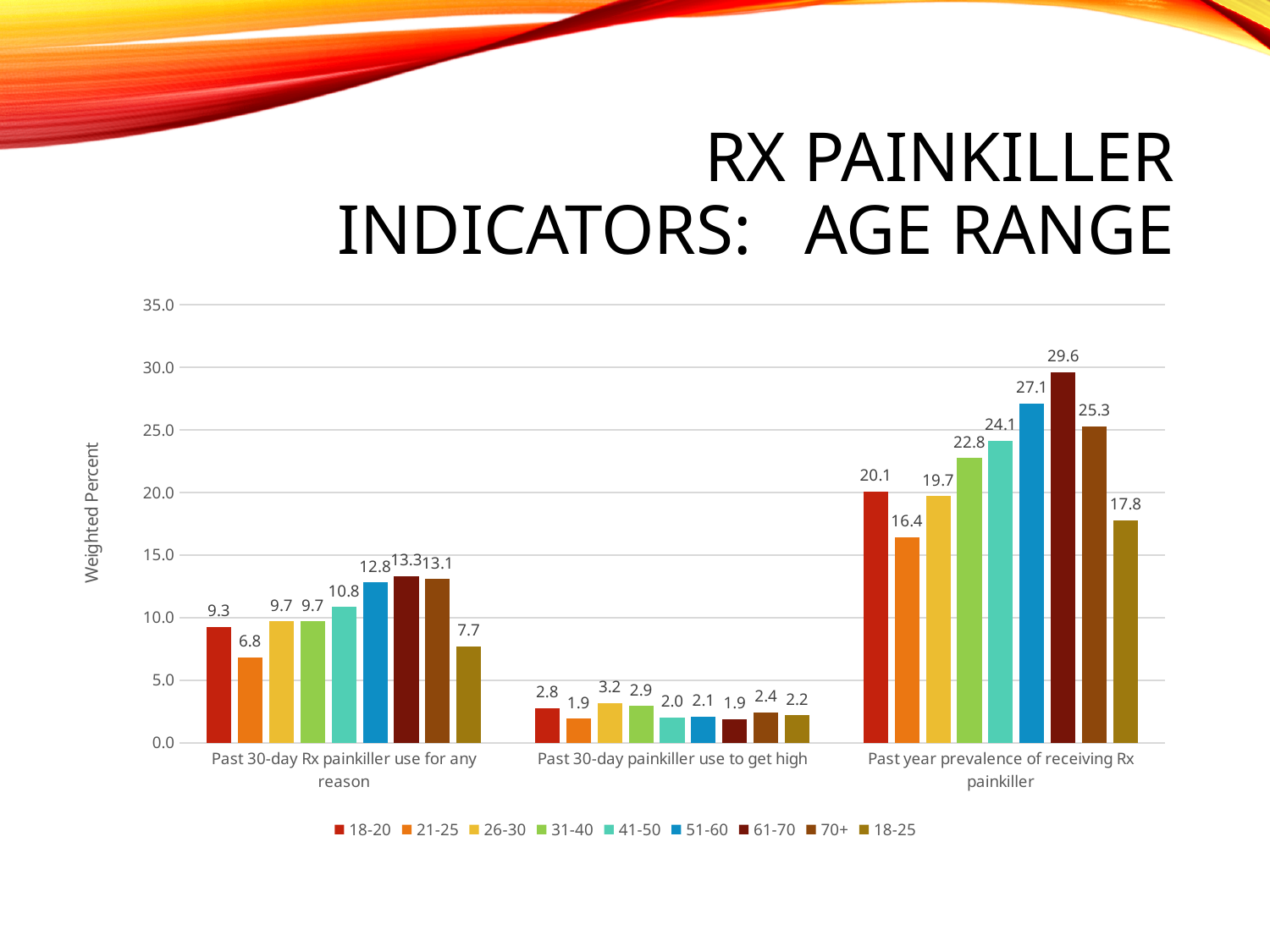
What is the value for the 70+ age group for Past year prevalence of receiving Rx painkiller? 25.3 What kind of chart is shown on the slide? Bar chart What is the value for the 26-30 age group for Past 30-day painkiller use to get high? 3.2 How many series does the legend list? 9 What is the difference between the 61-70 and 21-25 values for Past year prevalence of receiving Rx painkiller? 13.2 Which age group has the lowest value for Past 30-day Rx painkiller use for any reason? 21-25 What is the value for the 61-70 age group for Past year prevalence of receiving Rx painkiller? 29.6 For Past 30-day Rx painkiller use for any reason, which is larger: the value for 51-60 or the value for 18-25? 51-60 What is the label of the y axis? Weighted Percent How many categories are shown on the x axis? 3 What is the value for the 21-25 age group for Past 30-day Rx painkiller use for any reason? 6.8 Which age group has the highest value for Past year prevalence of receiving Rx painkiller? 61-70